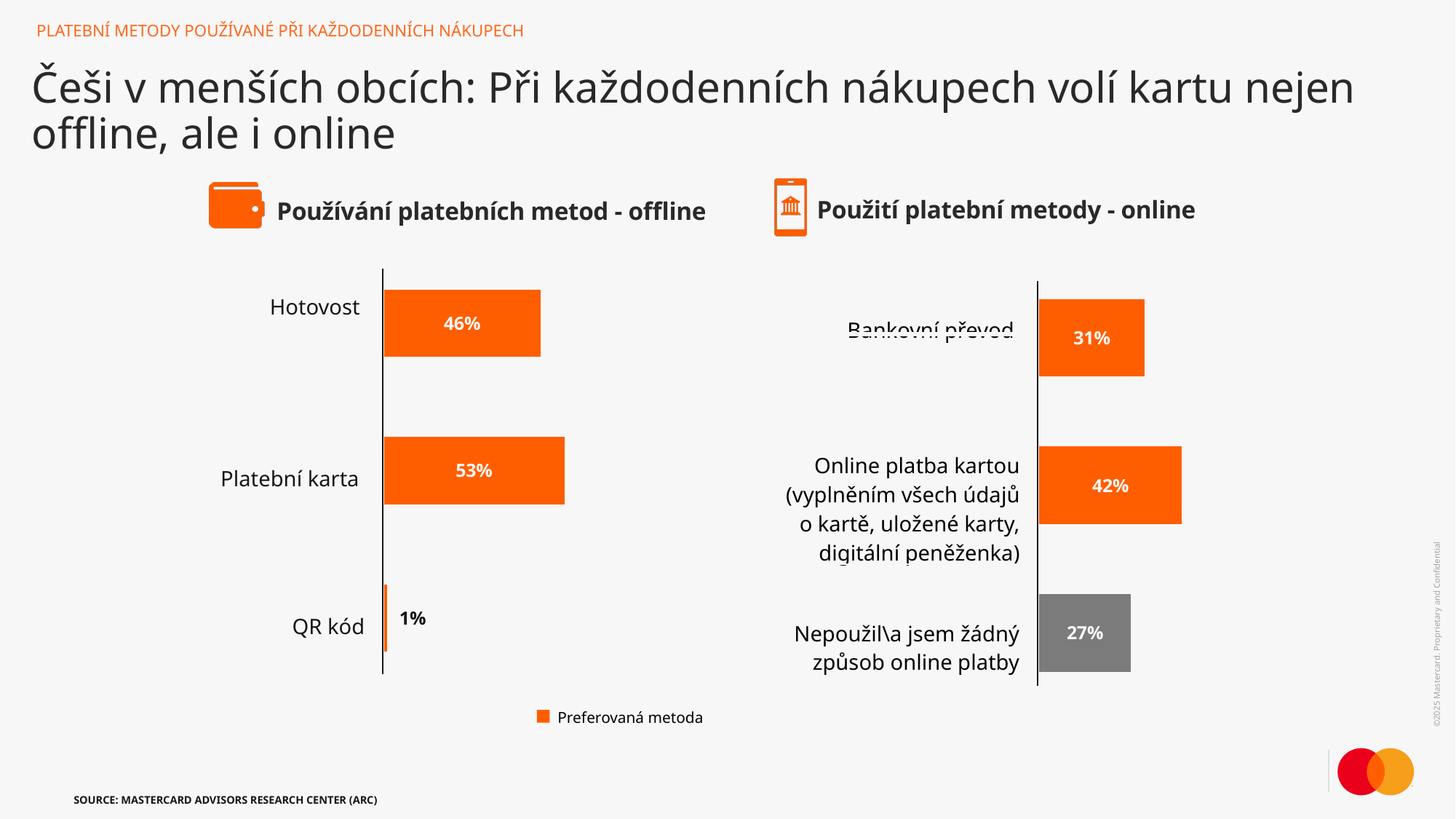
In the 'Použití platební metody - online' chart, what is the difference between Online platba kartou and Bankovní převod? 11% What kind of chart is the 'Použití platební metody - online' chart? Bar chart In the 'Použití platební metody - online' chart, which category has the highest value? Online platba kartou In the 'Používání platebních metod - offline' chart, which category has the lowest value? QR kód In the 'Použití platební metody - online' chart, what is the value for Online platba kartou? 42% In the 'Použití platební metody - online' chart, what is the value for Bankovní převod? 31% In the 'Používání platebních metod - offline' chart, which category has the highest value? Platební karta How many categories are shown in the 'Používání platebních metod - offline' chart? 3 In the 'Používání platebních metod - offline' chart, what is the difference between Platební karta and Hotovost? 7% In the 'Používání platebních metod - offline' chart, what is the value for Hotovost? 46% In the 'Používání platebních metod - offline' chart, what is the value for QR kód? 1% In the 'Použití platební metody - online' chart, which is larger: Bankovní převod or Nepoužil/a jsem žádný způsob online platby? Bankovní převod